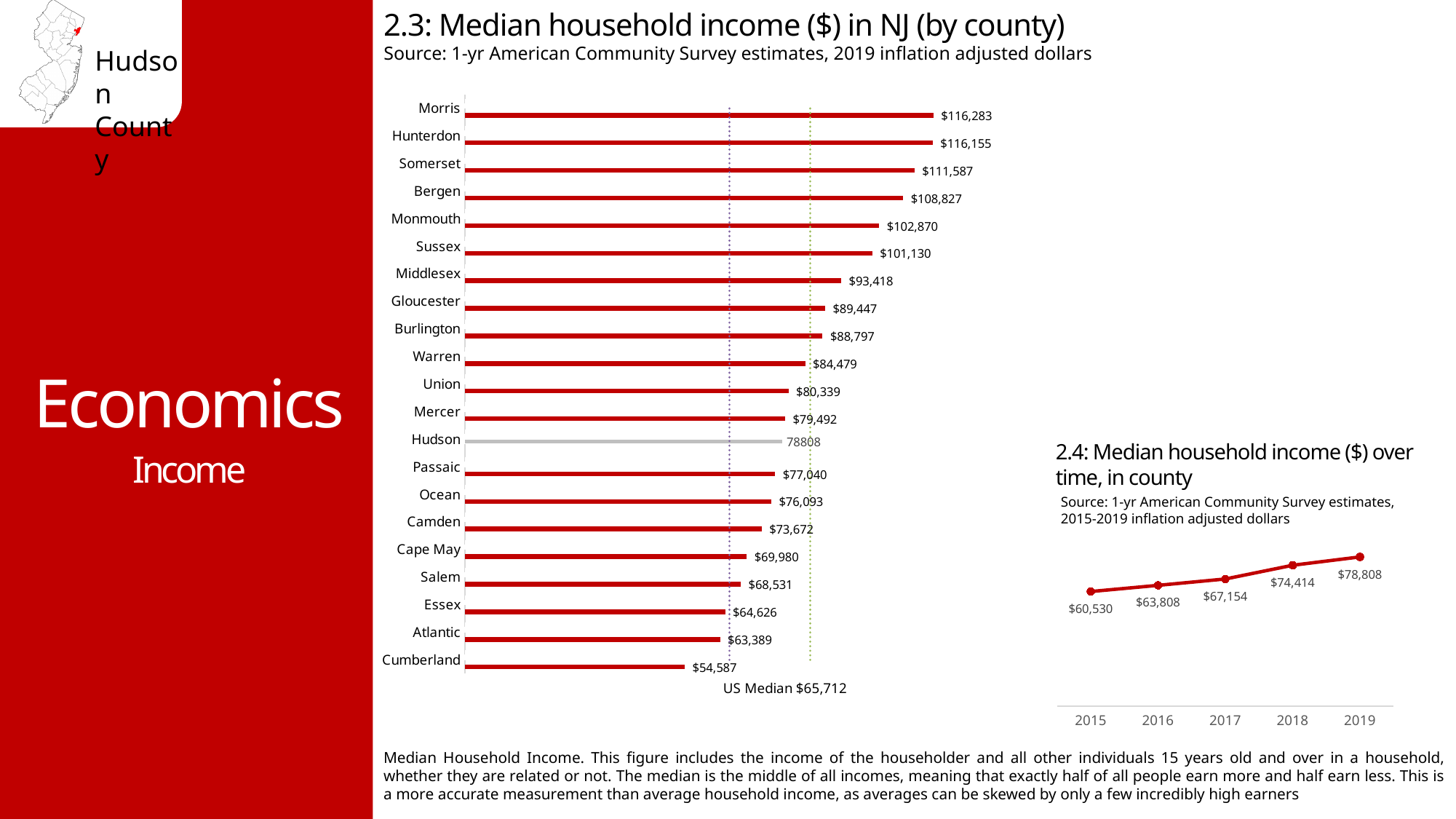
In chart 2.3, what is the difference between the median household income of Morris and Hunterdon? $128 In chart 2.3, what value is labelled for Hudson? 78808 What US Median value is noted below chart 2.3? $65,712 In chart 2.4 (Median household income over time, in county), what was the median household income in 2017? $67,154 In chart 2.3, which county has the highest median household income? Morris What type of chart is chart 2.3? Bar chart In chart 2.4, does the median household income rise or fall from 2015 to 2019? Rise In chart 2.3 (Median household income in NJ by county), what is the median household income for Bergen? $108,827 How many counties are shown in chart 2.3? 21 In chart 2.4, what is the difference between the 2019 and 2015 values? $18,278 In chart 2.3, which county has a higher median household income, Passaic or Camden? Passaic In chart 2.3, which county has the lowest median household income? Cumberland